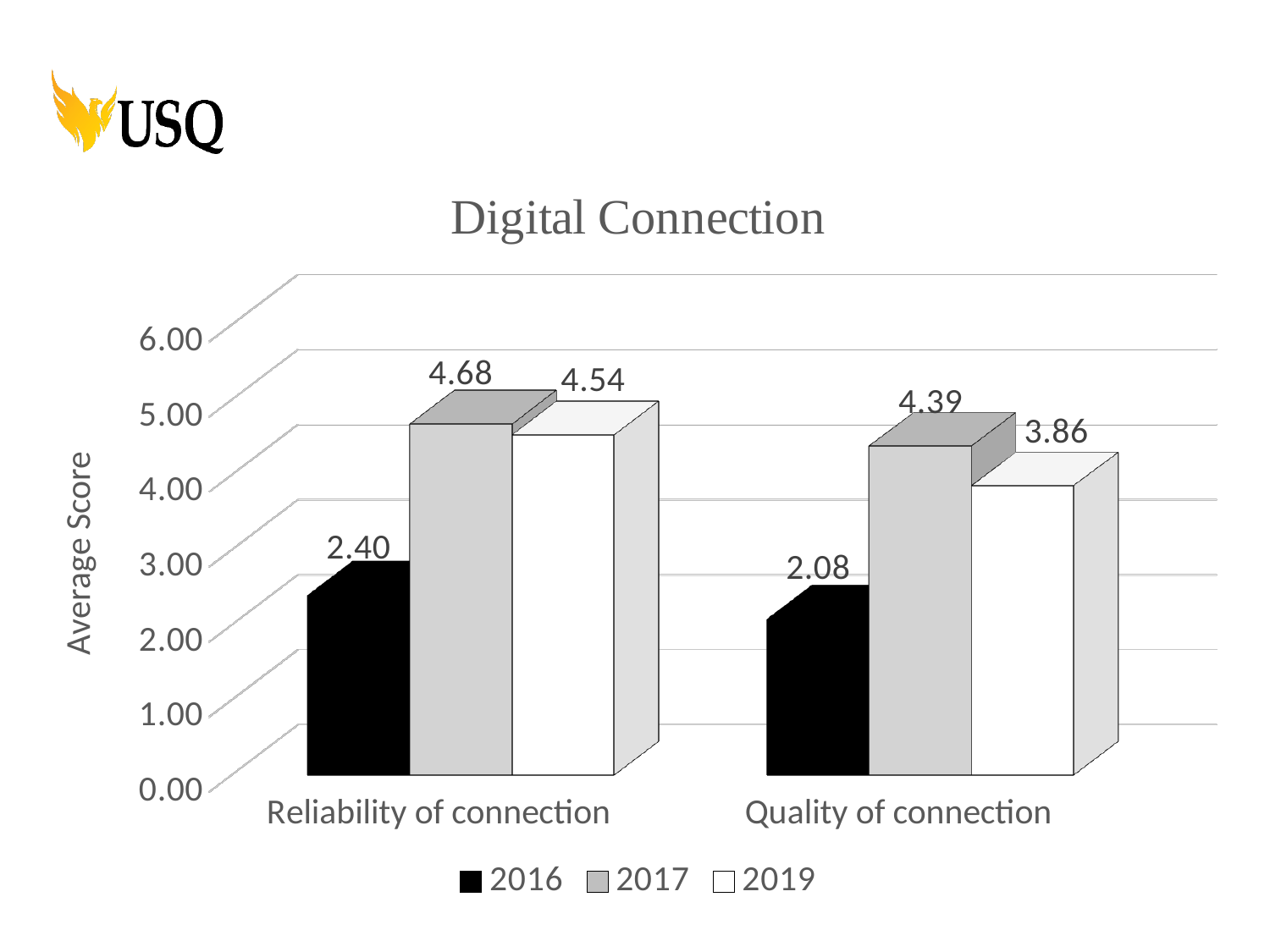
What is the difference between the 2017 and 2016 average scores for Reliability of connection? 2.28 What is the 2019 average score for Quality of connection? 3.86 How many series does the legend list? 3 What is the title of the chart? Digital Connection What kind of chart is shown on the slide? Bar chart What is the difference between the 2017 and 2019 average scores for Quality of connection? 0.53 What is the 2016 average score for Quality of connection? 2.08 Which year has the lowest average score for Quality of connection? 2016 Which is larger: the 2019 score for Reliability of connection or the 2019 score for Quality of connection? Reliability of connection What is the 2017 average score for Reliability of connection? 4.68 What is the 2019 average score for Reliability of connection? 4.54 Which year has the highest average score for Reliability of connection? 2017